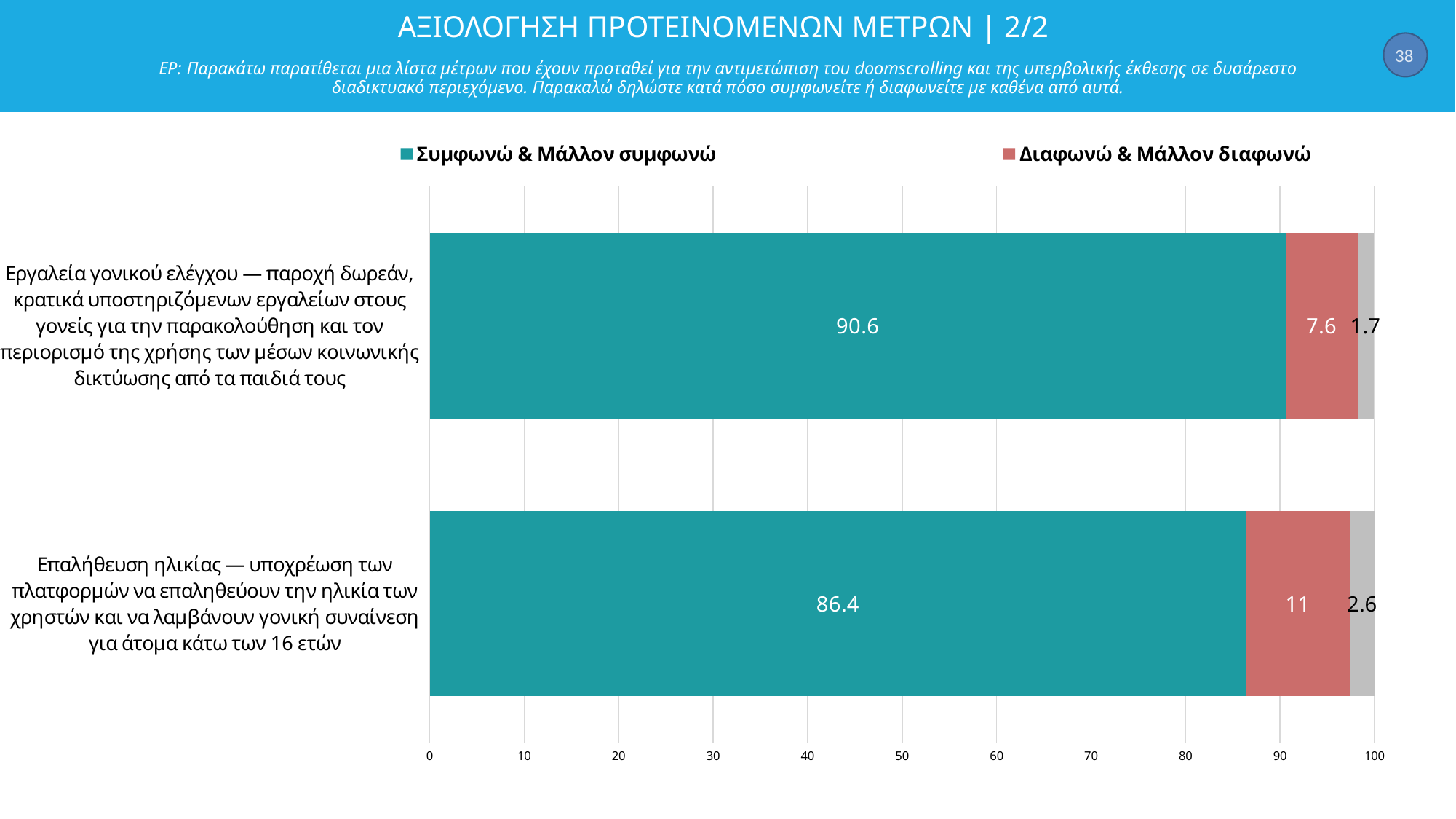
What is the value of "Διαφωνώ & Μάλλον διαφωνώ" for the measure "Εργαλεία γονικού ελέγχου"? 7.6 How many series does the legend list? 2 Is the "Διαφωνώ & Μάλλον διαφωνώ" value for "Επαλήθευση ηλικίας" larger or smaller than the one for "Εργαλεία γονικού ελέγχου"? larger Which measure has the higher "Συμφωνώ & Μάλλον συμφωνώ" value? Εργαλεία γονικού ελέγχου What is the value of "Συμφωνώ & Μάλλον συμφωνώ" for the measure "Επαλήθευση ηλικίας"? 86.4 What is the difference between the "Διαφωνώ & Μάλλον διαφωνώ" values for "Επαλήθευση ηλικίας" and "Εργαλεία γονικού ελέγχου"? 3.4 What is the value of "Συμφωνώ & Μάλλον συμφωνώ" for the measure "Εργαλεία γονικού ελέγχου"? 90.6 What kind of chart is shown on the slide? Stacked bar chart What is the difference between the "Συμφωνώ & Μάλλον συμφωνώ" values for "Εργαλεία γονικού ελέγχου" and "Επαλήθευση ηλικίας"? 4.2 What is the value of "Διαφωνώ & Μάλλον διαφωνώ" for the measure "Επαλήθευση ηλικίας"? 11 How many measures (categories) are shown in the chart? 2 Which measure has the lower "Διαφωνώ & Μάλλον διαφωνώ" value? Εργαλεία γονικού ελέγχου